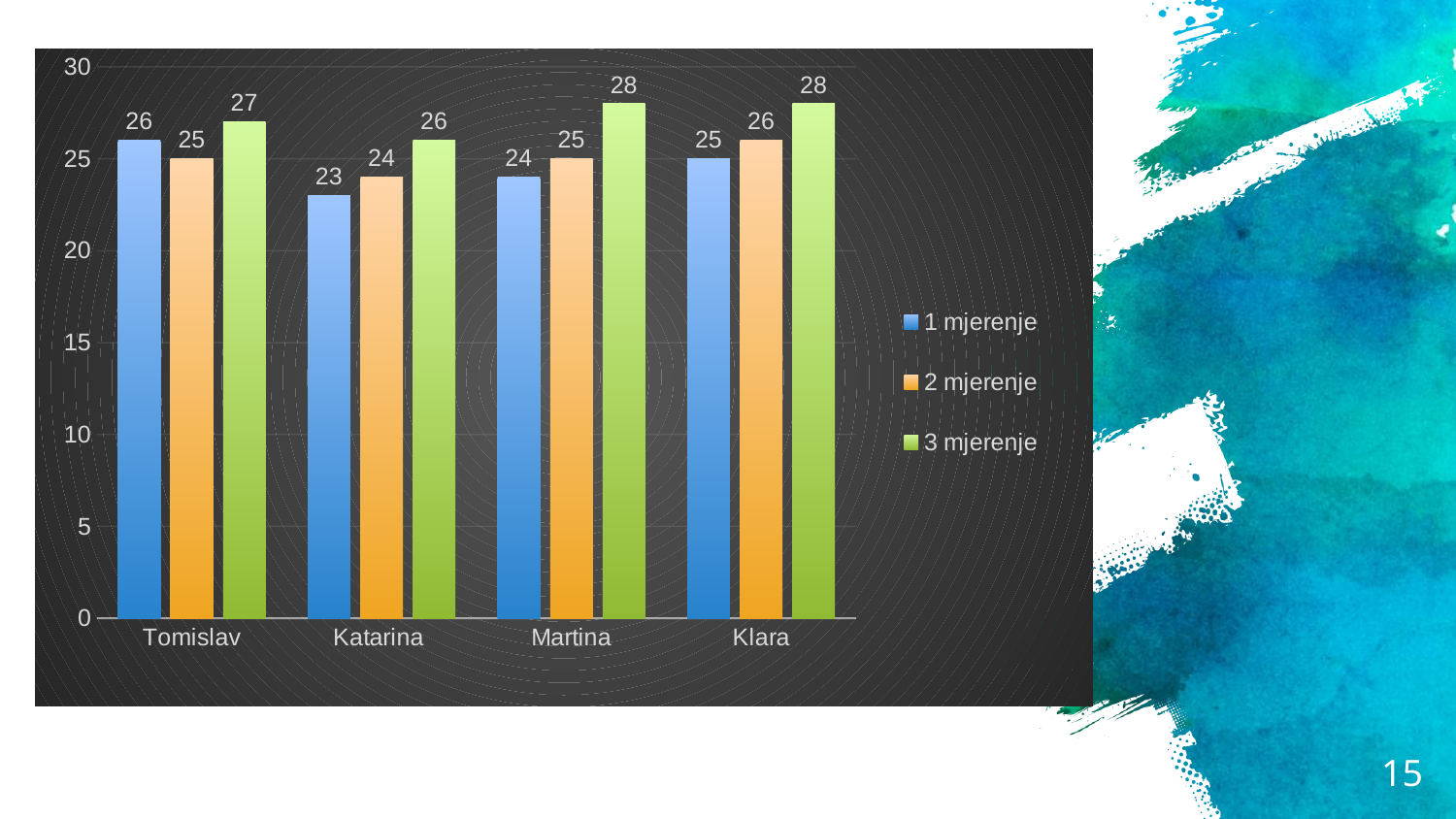
Is the 3 mjerenje value for Klara greater or less than 25? greater Which category has the lowest value for 1 mjerenje? Katarina How many categories are shown on the x axis? 4 What is the difference between the 3 mjerenje and 1 mjerenje values for Martina? 4 How many series does the legend list? 3 What is the value of 3 mjerenje for Katarina? 26 Which is larger: the 1 mjerenje value for Tomislav or the 1 mjerenje value for Klara? Tomislav Which colour represents the 2 mjerenje series in the legend? orange Which category has the highest value for 2 mjerenje? Klara What is the value of 1 mjerenje for Tomislav? 26 What kind of chart is shown on the slide? bar chart What is the value of 2 mjerenje for Martina? 25